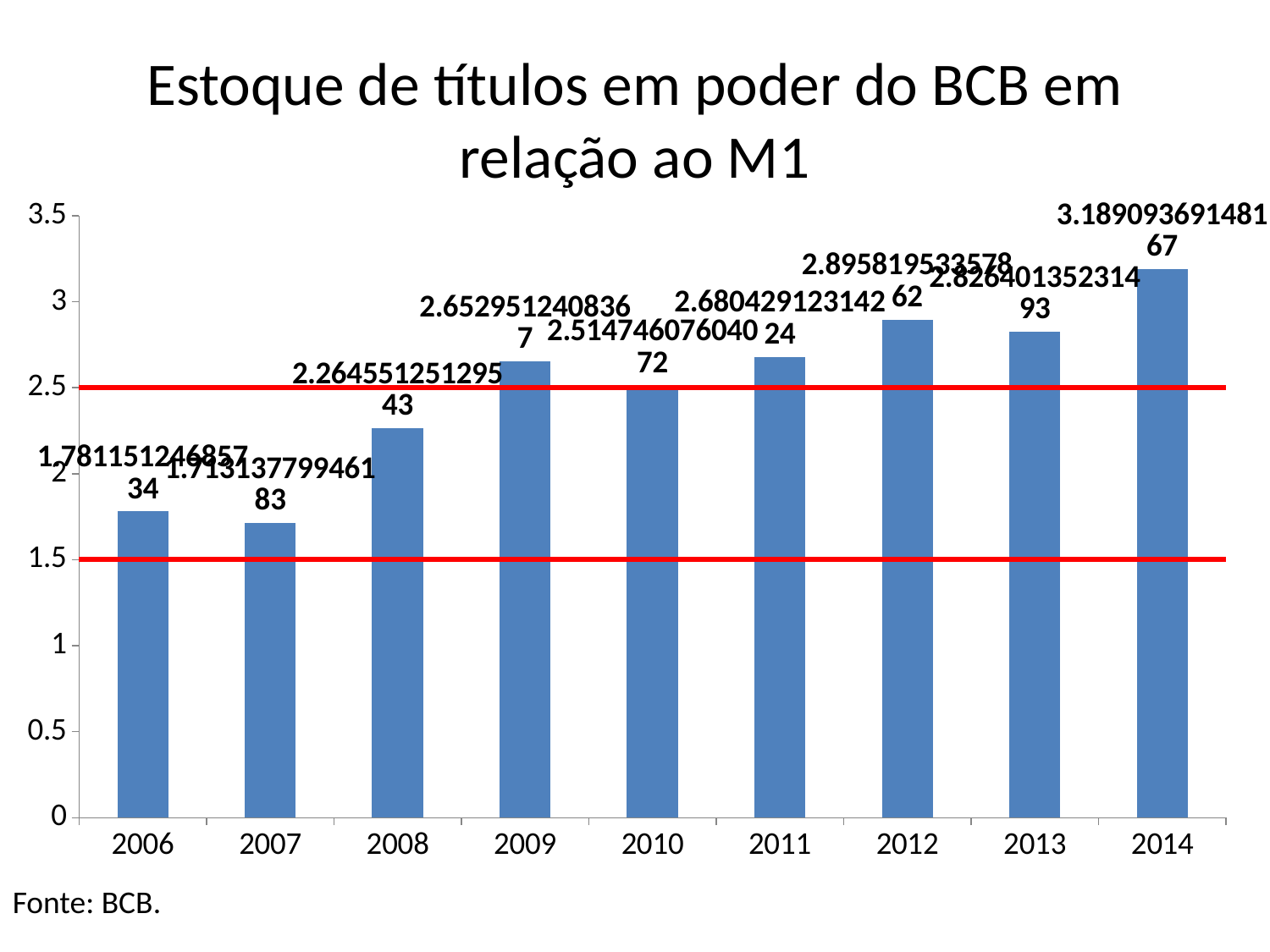
What kind of chart is this? bar chart Is the value for 2008 greater or less than 2.5? less What is the value for 2009? 2.6529512408367 At which two values are the red horizontal lines drawn? 1.5 and 2.5 What is the value for 2014? 3.18909369148167 Which is larger, the value for 2009 or the value for 2010? 2009 Which year has the lowest value? 2007 Is the value for 2006 greater or less than 1.5? greater What is the value for 2011? 2.68042912314224 How many years are shown on the x axis? 9 What is the value for 2008? 2.26455125129543 Which year has the highest value? 2014